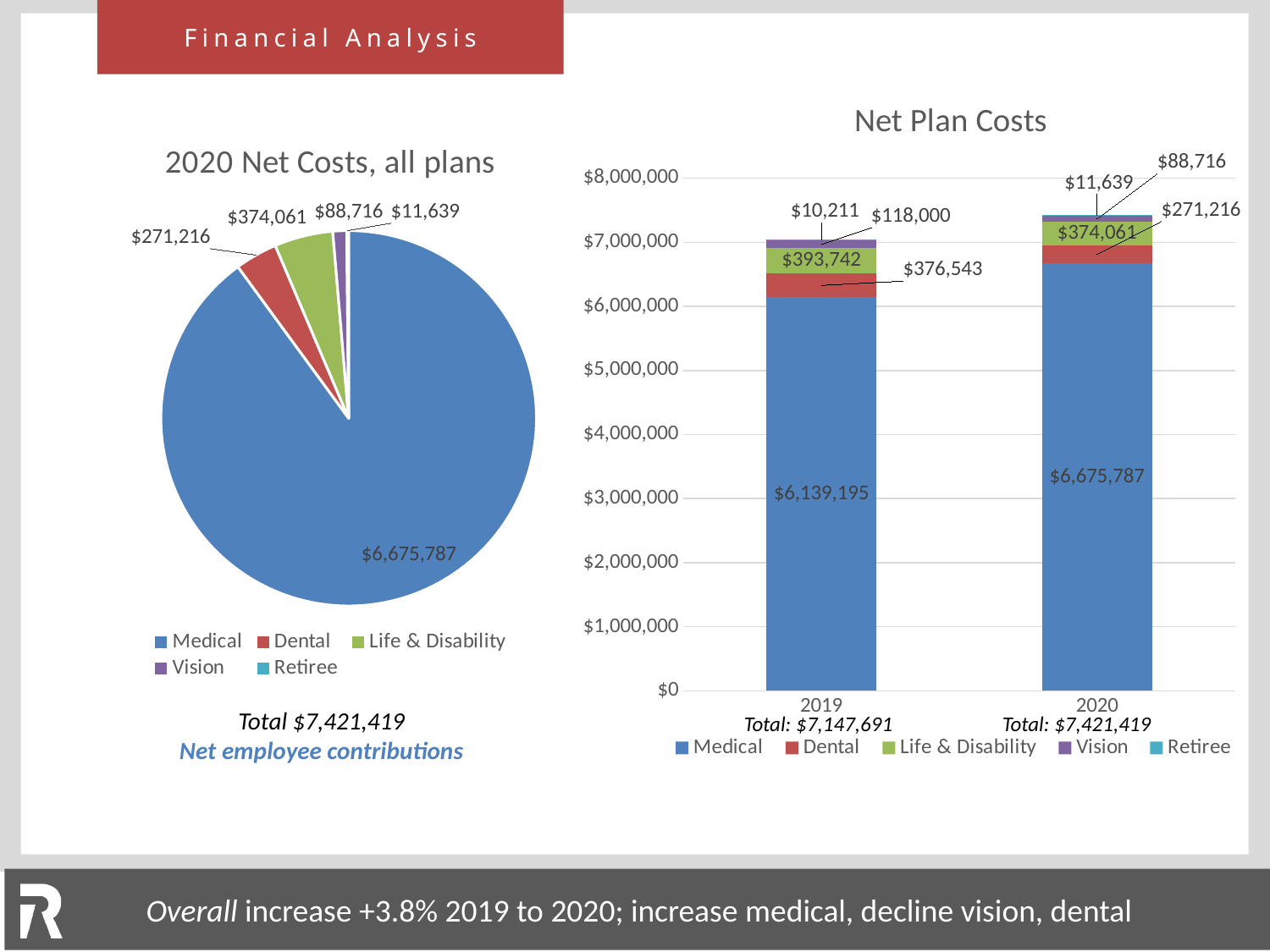
In the 'Net Plan Costs' chart, what is the Vision value for 2019? $118,000 In the 'Net Plan Costs' chart, what is the Medical value for 2019? $6,139,195 In the 'Net Plan Costs' chart, what is the total for the 2019 bar? $7,147,691 What kind of chart is the '2020 Net Costs, all plans' chart? Pie chart In the 'Net Plan Costs' chart, which year has the larger Dental value, 2019 or 2020? 2019 In the 'Net Plan Costs' chart, by how much did the Medical value increase from 2019 to 2020? $536,592 In the '2020 Net Costs, all plans' pie chart, which category has the smallest slice? Retiree What kind of chart is the 'Net Plan Costs' chart? Stacked bar chart In the '2020 Net Costs, all plans' pie chart, what is the value for Medical? $6,675,787 How many categories does the legend of the '2020 Net Costs, all plans' pie chart list? 5 In the '2020 Net Costs, all plans' pie chart, which category has the largest slice? Medical In the '2020 Net Costs, all plans' pie chart, what is the value for Dental? $271,216